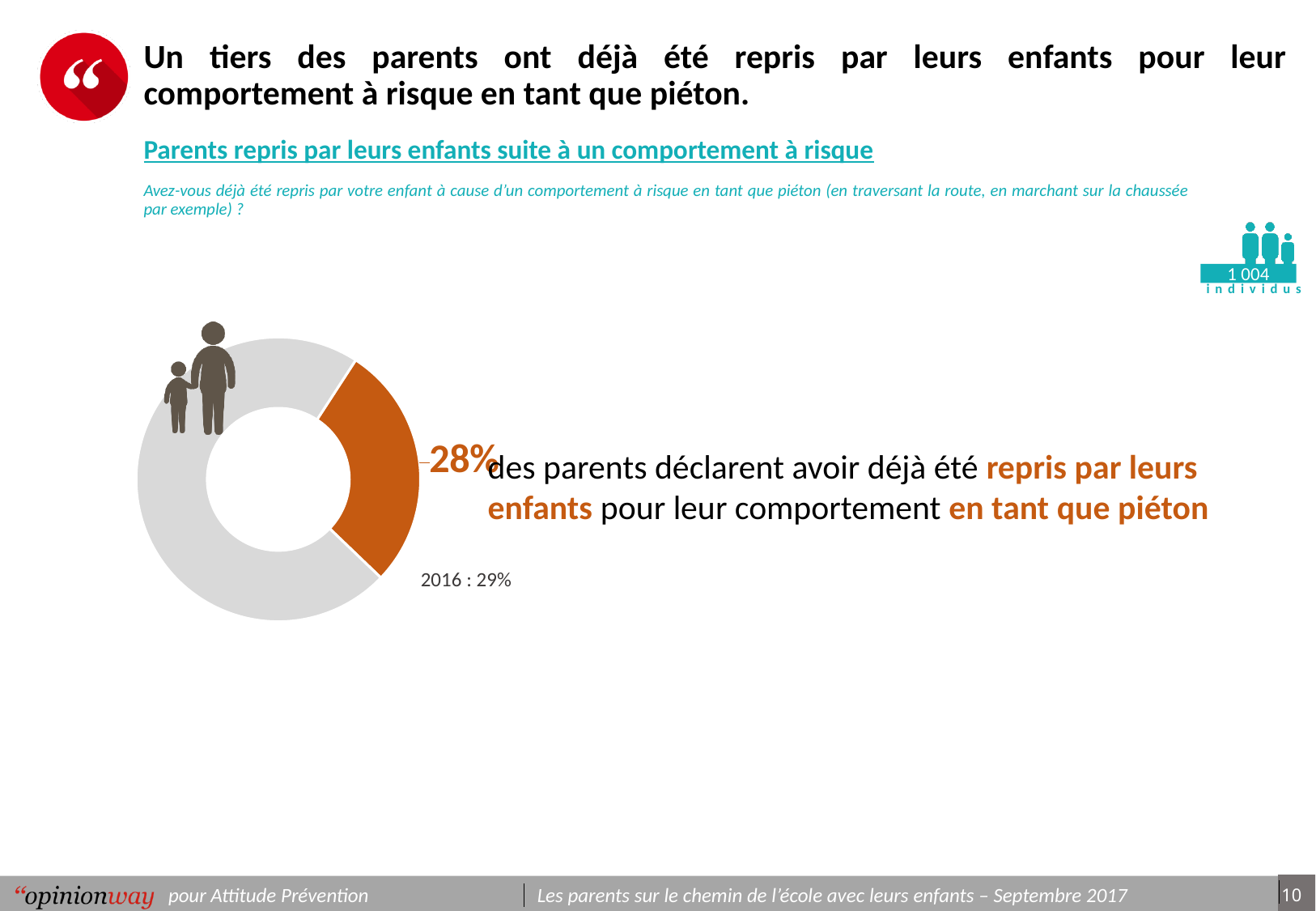
Is the orange slice of the pie greater or less than 50%? less What percentage of parents declare having already been corrected by their children for their behaviour as a pedestrian, according to the chart? 28% Which slice of the pie is larger, the orange slice or the grey slice? The grey slice What was the corresponding value in 2016, as noted next to the chart? 29% How many slices does the pie chart have? 2 By how many percentage points did the value change from 2016 (29%) to the current 28%? 1 point lower How many individuals were surveyed, according to the sample indicator on the slide? 1 004 individus What kind of chart is shown on the slide? Pie chart (donut) What is the title of the chart section on the slide? Parents repris par leurs enfants suite à un comportement à risque What share of the pie does the orange slice represent? 28%